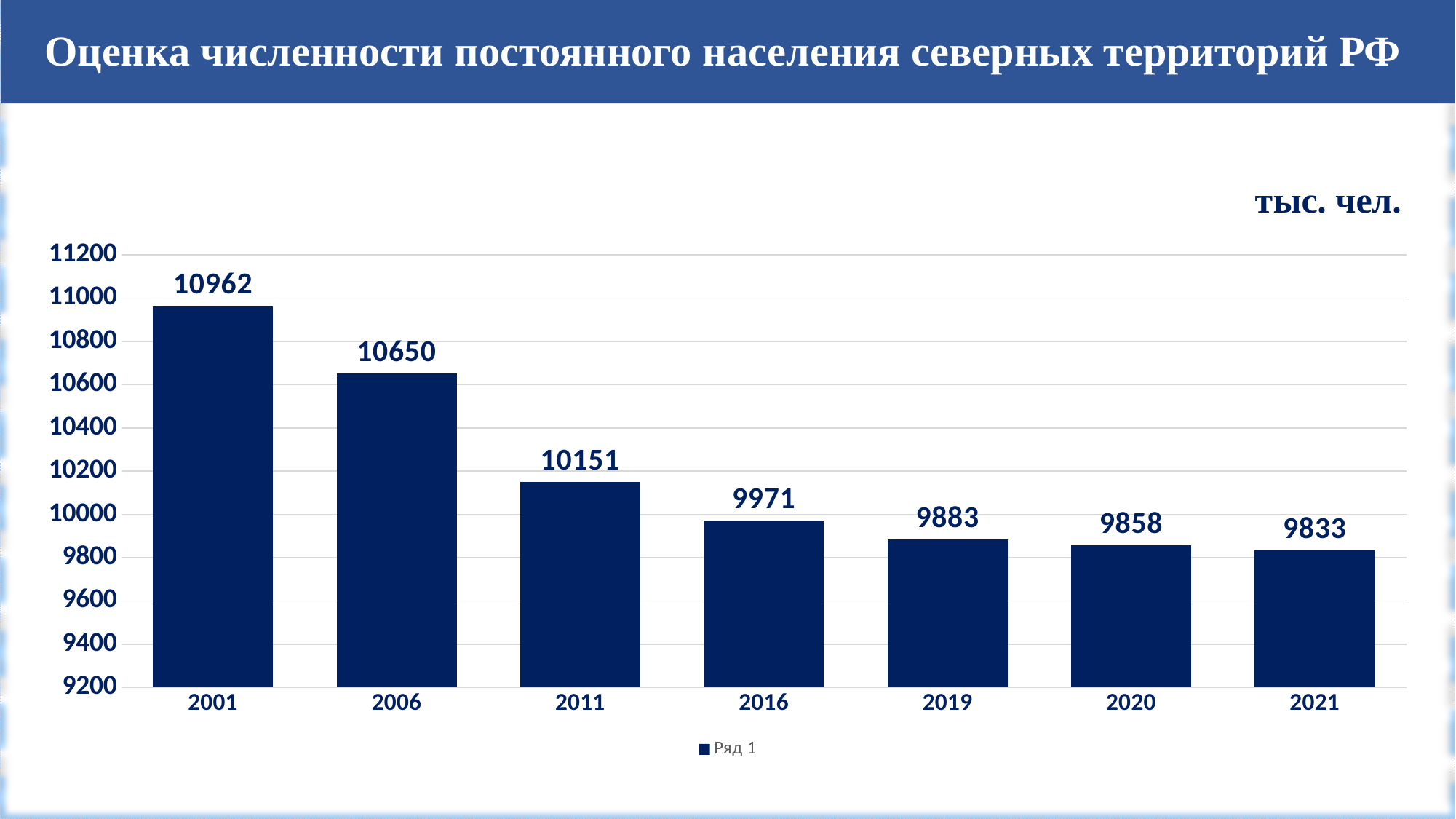
Which year has the lowest value? 2021 What is the difference between the values for 2001 and 2006? 312 What is the value for 2016? 9971 What is the difference between the values for 2011 and 2016? 180 What kind of chart is shown on the slide? bar chart What is the value for 2021? 9833 Which is larger, the value for 2006 or the value for 2011? 2006 Do the values rise or fall from 2001 to 2021? fall How many series does the legend list? 1 How many years are shown on the x axis? 7 What is the value for 2001? 10962 Which year has the highest value? 2001